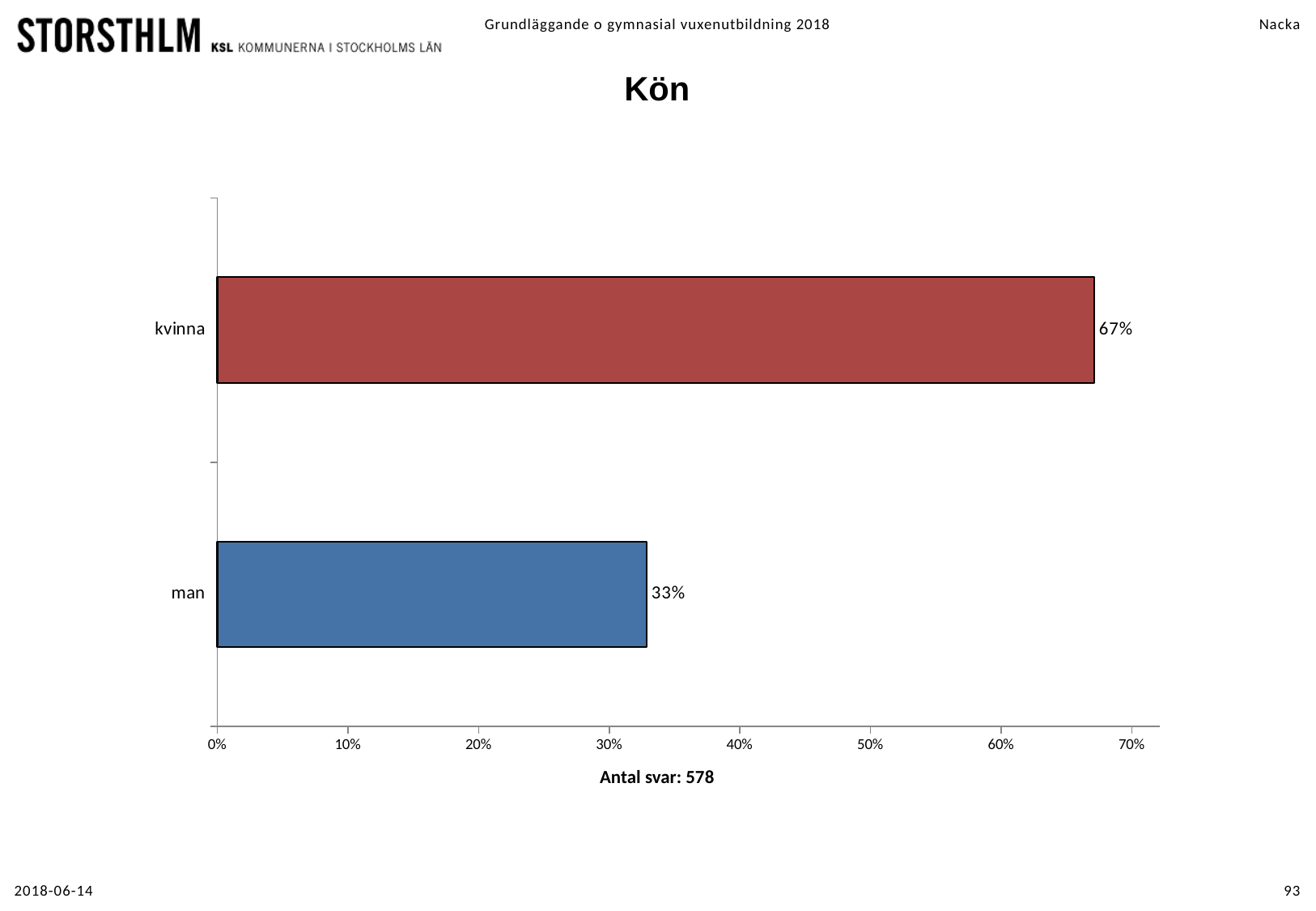
What is the value for kvinna? 67% What is the title of the chart? Kön What is the number of responses (Antal svar) shown below the chart? 578 Which category has the lowest value? man What is the value for man? 33% Which category has the highest value? kvinna Is the value for man greater or less than 40%? less Is the value for kvinna greater or less than 60%? greater How many categories are shown in the chart? 2 What kind of chart is shown on the slide? bar chart What is the difference between the values for kvinna and man? 34% Which is larger, the value for kvinna or the value for man? kvinna